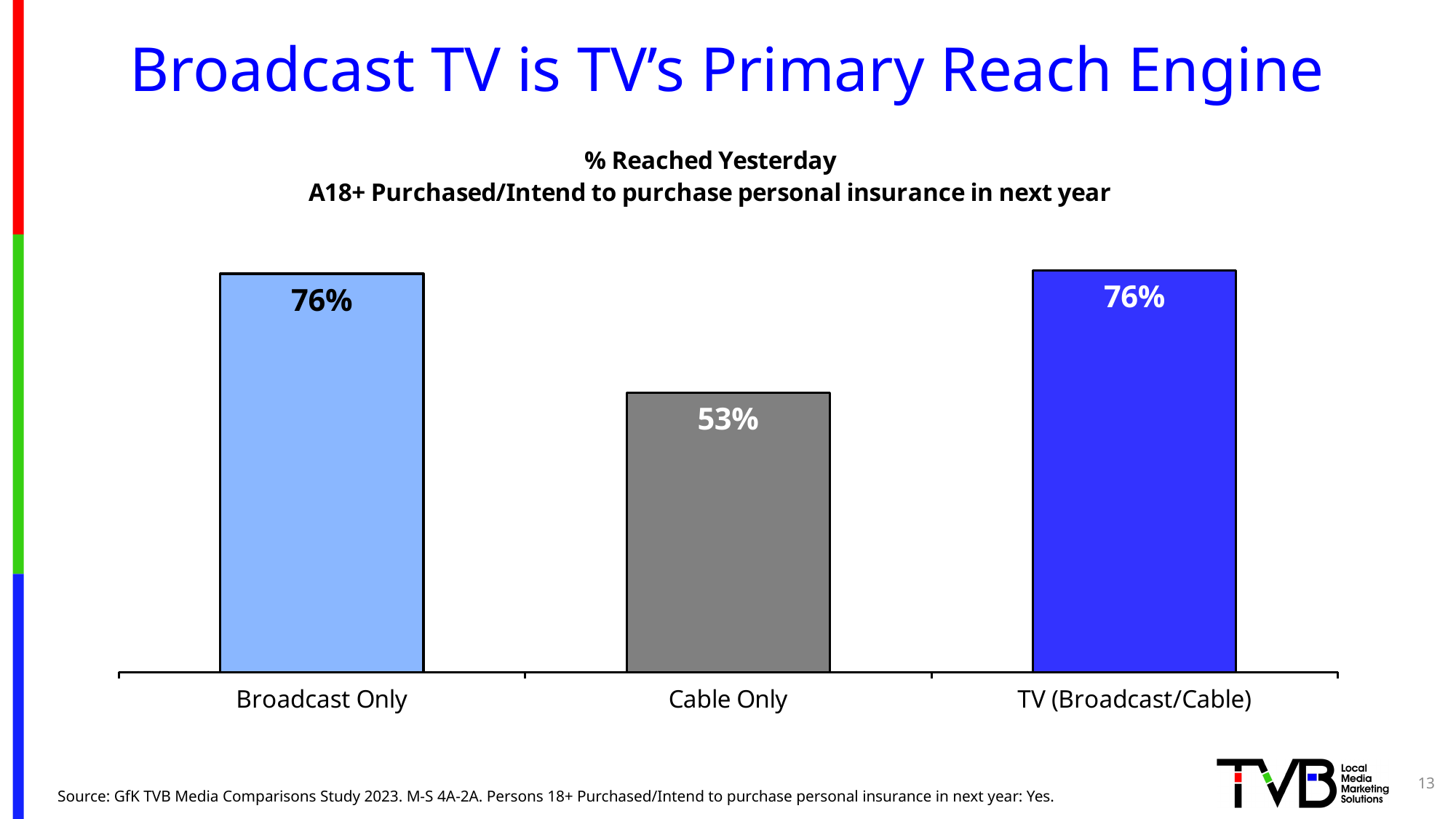
How many categories are shown in the chart? 3 What is the value for TV (Broadcast/Cable)? 76% What colour is the Cable Only bar? Gray Which category has the lowest value? Cable Only What is the value for Cable Only? 53% What is the value for Broadcast Only? 76% What is the title of the chart? % Reached Yesterday A18+ Purchased/Intend to purchase personal insurance in next year Which is larger, the value for Broadcast Only or the value for Cable Only? Broadcast Only Which is larger, the value for TV (Broadcast/Cable) or the value for Cable Only? TV (Broadcast/Cable) What is the difference between the Broadcast Only and Cable Only values? 23% What kind of chart is shown on the slide? Bar chart